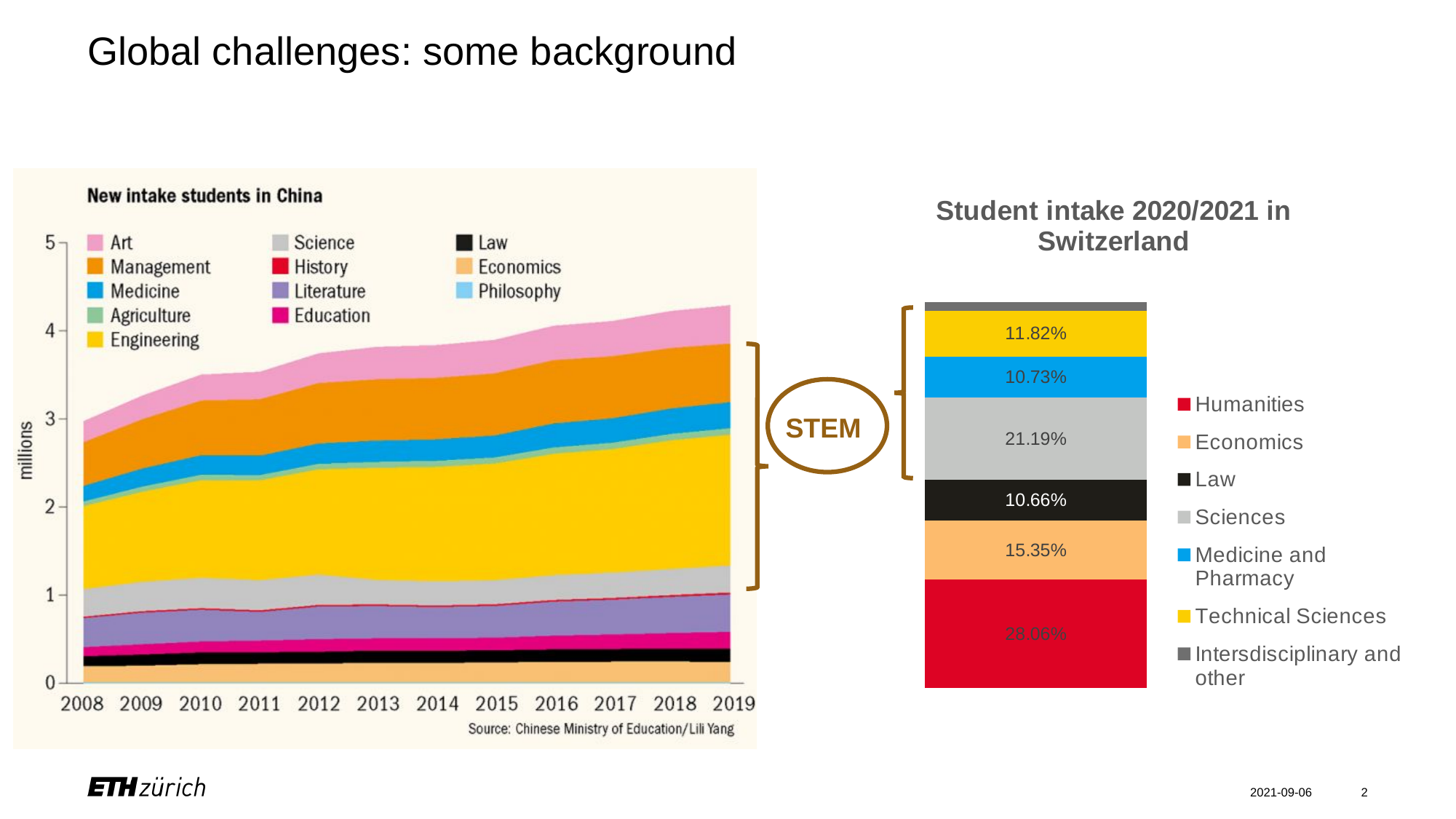
In the 'New intake students in China' chart, is the total for 2019 greater or less than 4 million? greater What kind of chart is the 'Student intake 2020/2021 in Switzerland' chart? Stacked bar chart How many series does the legend of the 'New intake students in China' chart list? 12 In the 'New intake students in China' chart, does the total number of new intake students rise or fall from 2008 to 2019? Rise In the 'Student intake 2020/2021 in Switzerland' chart, which labelled category has the largest share? Humanities How many years are shown on the x axis of the 'New intake students in China' chart? 12 In the 'Student intake 2020/2021 in Switzerland' chart, what percentage is shown for Technical Sciences? 11.82% In the 'Student intake 2020/2021 in Switzerland' chart, which is larger: Medicine and Pharmacy or Law? Medicine and Pharmacy In the 'Student intake 2020/2021 in Switzerland' chart, what is the difference between the Humanities and Economics percentages? 12.71% How many entries does the legend of the 'Student intake 2020/2021 in Switzerland' chart list? 7 In the 'Student intake 2020/2021 in Switzerland' chart, what percentage is shown for Sciences? 21.19% In the 'Student intake 2020/2021 in Switzerland' chart, what percentage is shown for Humanities? 28.06%